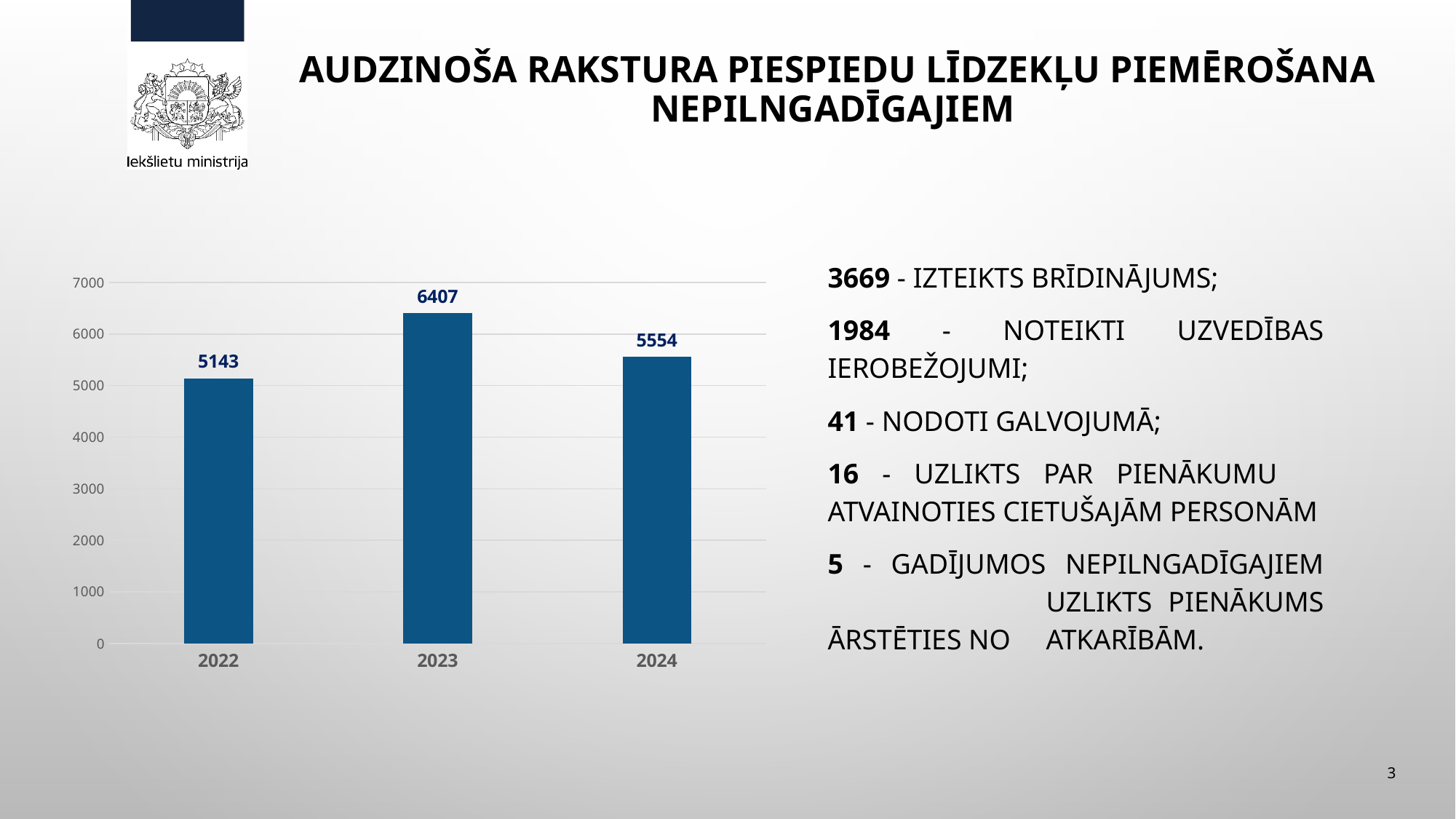
Which is larger, the value for 2024 or the value for 2022? 2024 How many years are shown on the chart? 3 What is the value for 2023? 6407 Is the value for 2023 greater or less than 6000? greater Does the value rise or fall from 2023 to 2024? fall What is the value for 2022? 5143 What kind of chart is shown on the slide? bar chart Which year has the highest value? 2023 What is the value for 2024? 5554 What is the difference between the values for 2023 and 2024? 853 Which year has the lowest value? 2022 What is the difference between the values for 2023 and 2022? 1264